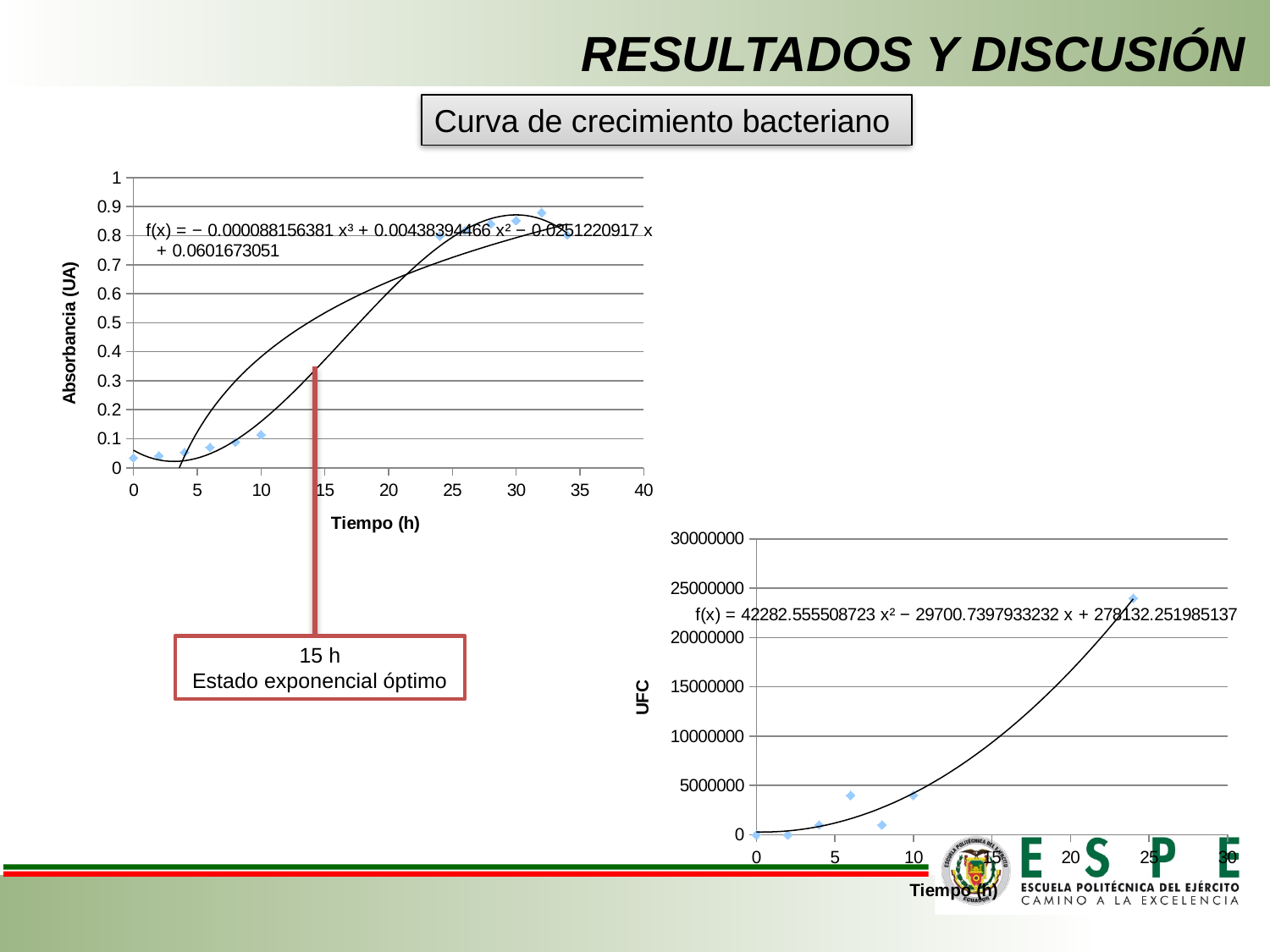
What is the y-axis label of the left chart? Absorbancia (UA) In the left chart (Absorbancia vs Tiempo), do the absorbance values generally rise or fall as time increases? rise What is the title shown above the charts on the slide? Curva de crecimiento bacteriano In the left chart, is the absorbance value at 30 h larger or smaller than the value at 8 h? larger What kind of chart is the left chart showing Absorbancia (UA) against Tiempo (h)? scatter chart In the lower-right chart (UFC vs Tiempo), is the highest plotted UFC value greater or less than 20000000? greater What kind of chart is the lower-right chart showing UFC against Tiempo (h)? scatter chart In the lower-right chart (UFC vs Tiempo), do the UFC values generally rise or fall as time increases? rise In the lower-right chart (UFC vs Tiempo), is the UFC value at 10 h greater or less than 5000000? less In the left chart (Absorbancia vs Tiempo), is the absorbance value at 10 h greater or less than 0.2? less